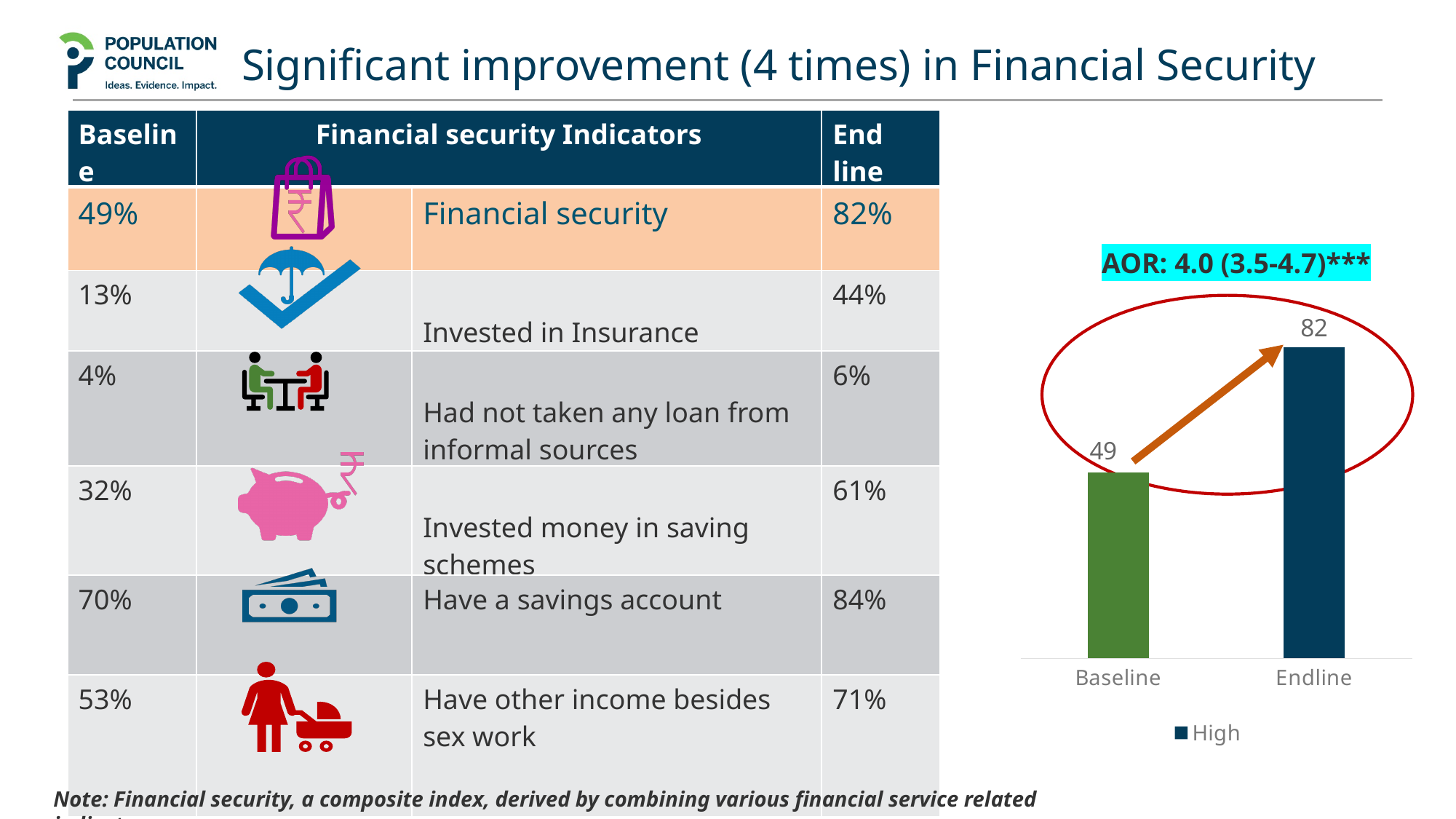
How many categories are shown on the x axis of the bar chart? 2 How many series does the legend of the bar chart list? 1 Which category has the higher value in the bar chart, Baseline or Endline? Endline What AOR value is annotated above the bar chart? AOR: 4.0 (3.5-4.7)*** What is the value for Endline in the bar chart? 82 Is the Baseline value larger or smaller than the Endline value in the bar chart? smaller What is the difference between the Endline and Baseline values in the bar chart? 33 What is the value for Baseline in the bar chart? 49 What type of chart is shown on the right of the slide? bar chart Which category has the lowest value in the bar chart? Baseline What is the name of the series listed in the bar chart's legend? High Do the values in the bar chart rise or fall from Baseline to Endline? rise